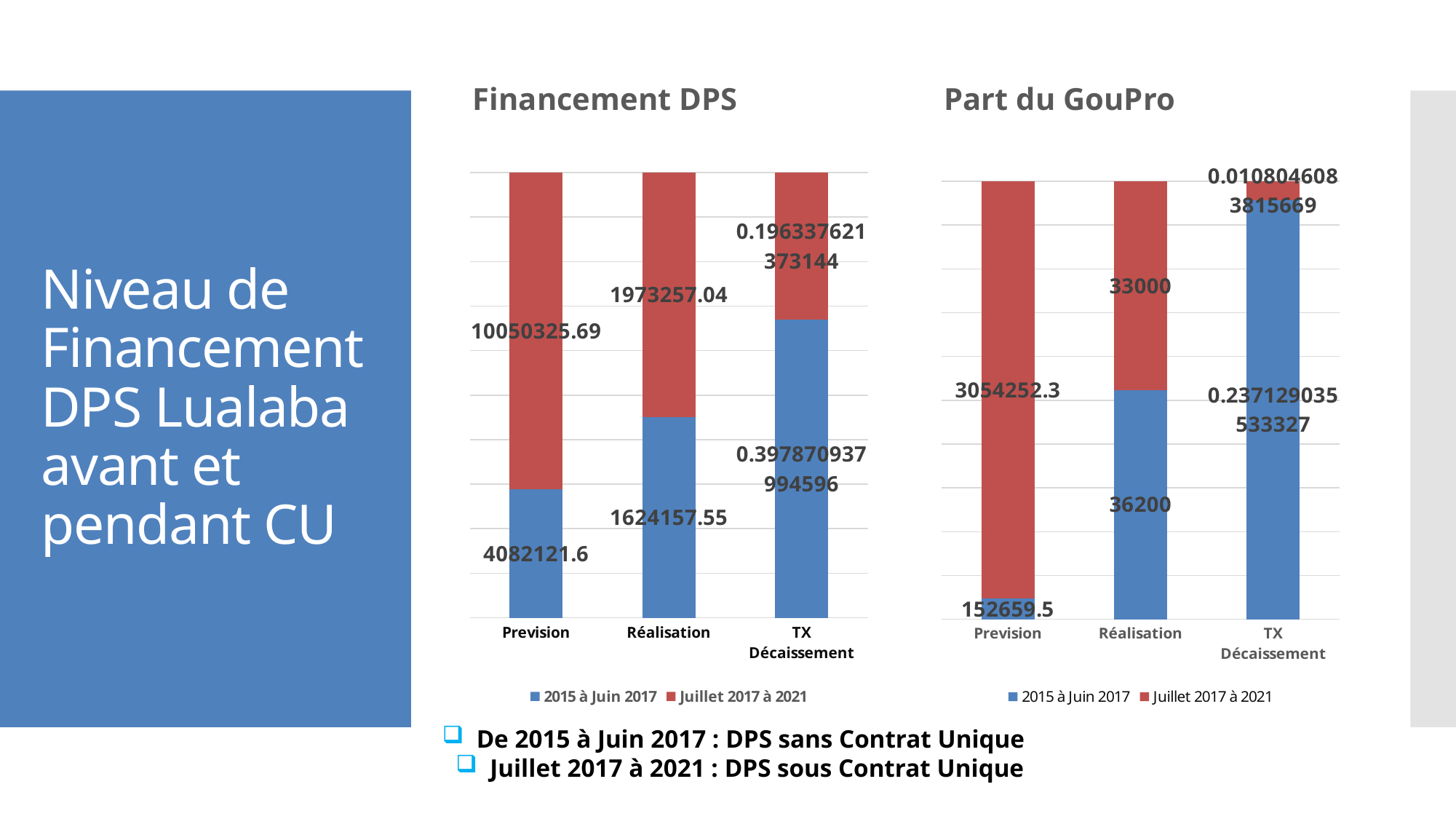
How many series does the legend of the 'Financement DPS' chart list? 2 In the 'Financement DPS' chart, for Prevision, which series has the larger value: '2015 à Juin 2017' or 'Juillet 2017 à 2021'? Juillet 2017 à 2021 In the 'Part du GouPro' chart, what is the value for Prevision in the 'Juillet 2017 à 2021' series? 3054252.3 In the 'Financement DPS' chart, what is the difference between the 'Juillet 2017 à 2021' and '2015 à Juin 2017' values for Réalisation? 349099.49 In the 'Financement DPS' chart, what is the value for Réalisation in the 'Juillet 2017 à 2021' series? 1973257.04 In the 'Part du GouPro' chart, for Réalisation, which series has the larger value: '2015 à Juin 2017' or 'Juillet 2017 à 2021'? 2015 à Juin 2017 In the 'Financement DPS' chart, what is the value for Prevision in the '2015 à Juin 2017' series? 4082121.6 What kind of chart is the 'Part du GouPro' chart? Stacked bar chart In the 'Part du GouPro' chart, what is the value for Réalisation in the '2015 à Juin 2017' series? 36200 How many categories are shown on the x axis of the 'Part du GouPro' chart? 3 In the 'Financement DPS' chart, what is the sum of the two series values for Prevision? 14132447.29 In the 'Part du GouPro' chart, what is the difference between the '2015 à Juin 2017' and 'Juillet 2017 à 2021' values for Réalisation? 3200